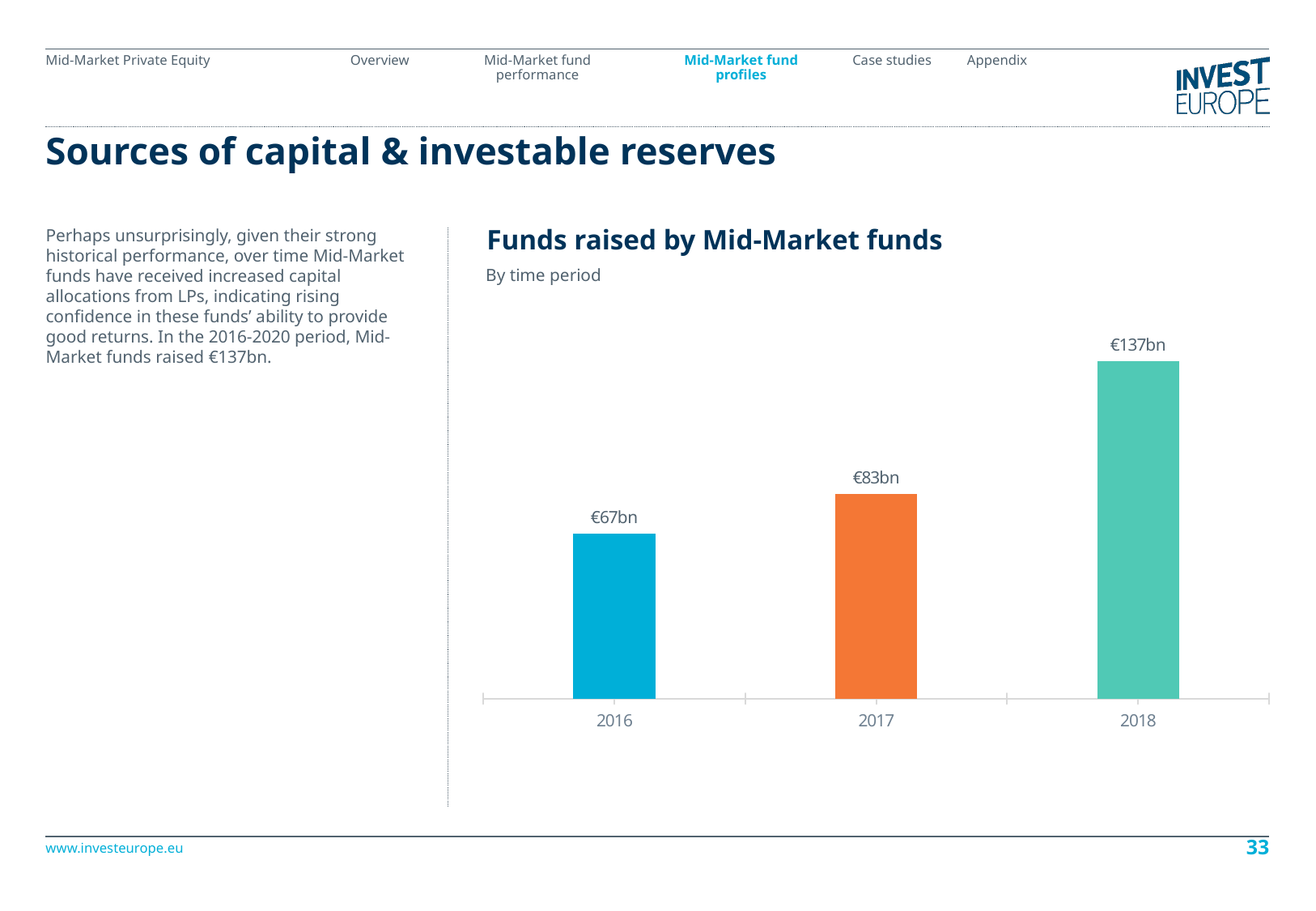
What value is shown for 2018 in the Funds raised by Mid-Market funds chart? €137bn Which time period has the highest funds raised in the chart? 2018 What is the difference between the funds raised in 2018 and in 2016? €70bn How many time periods are shown on the x axis of the chart? 3 What is the difference between the funds raised in 2017 and in 2016? €16bn What value is shown for 2017 in the Funds raised by Mid-Market funds chart? €83bn What kind of chart is used to show funds raised by Mid-Market funds? Bar chart What value is shown for 2016 in the Funds raised by Mid-Market funds chart? €67bn Which time period has the lowest funds raised in the chart? 2016 What is the subtitle shown under the chart title? By time period Which is larger, the funds raised in 2017 or in 2016? 2017 Do the funds raised rise or fall from 2016 to 2018? Rise